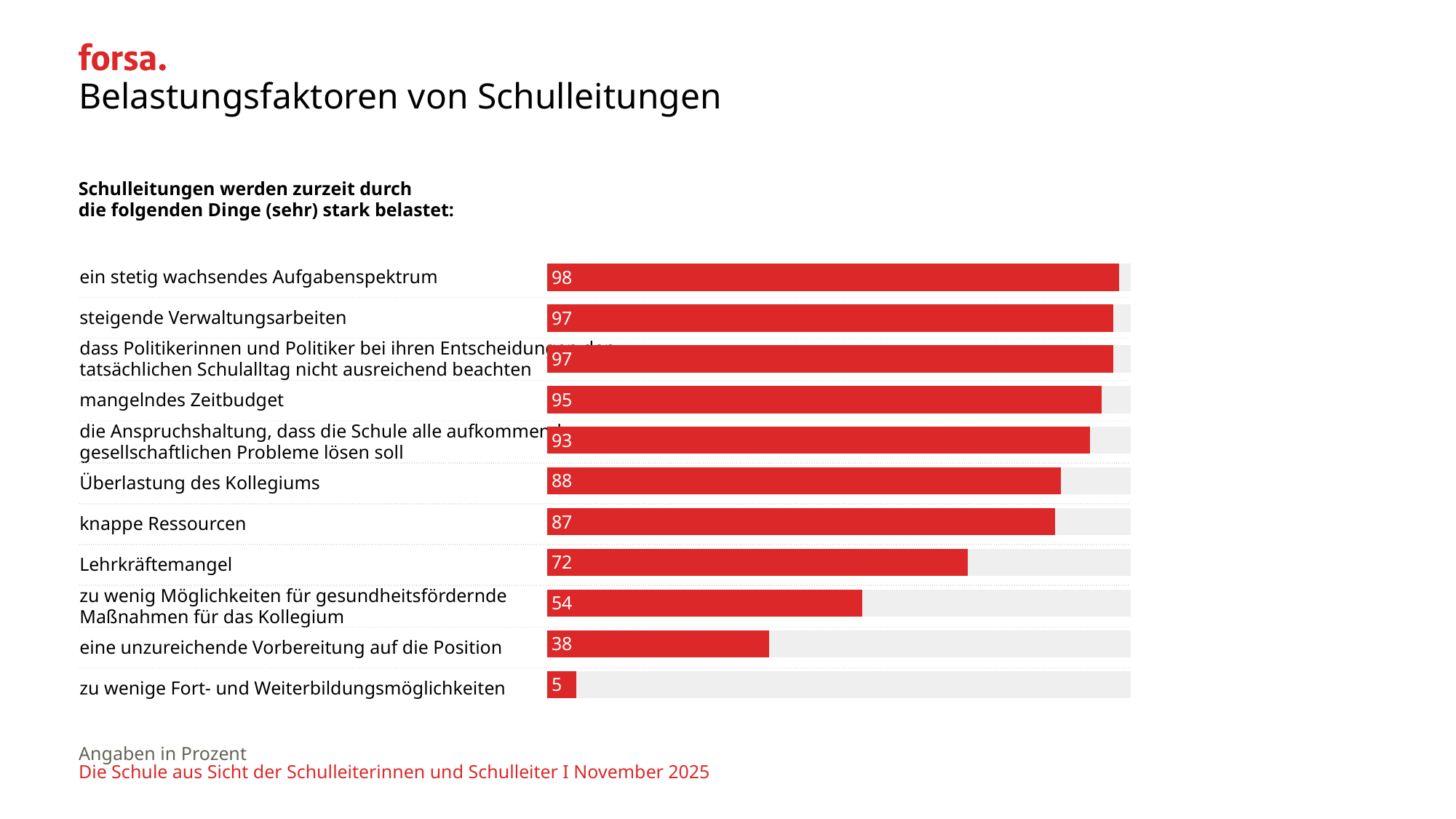
What value is shown for "eine unzureichende Vorbereitung auf die Position"? 38 In what unit are the values given, according to the note below the chart? Prozent Which is larger: the value for "knappe Ressourcen" or the value for "zu wenig Möglichkeiten für gesundheitsfördernde Maßnahmen für das Kollegium"? knappe Ressourcen What is the difference between the values for "Überlastung des Kollegiums" and "Lehrkräftemangel"? 16 Which category has the highest value? ein stetig wachsendes Aufgabenspektrum What kind of chart is shown on the slide? bar chart What value is shown for "mangelndes Zeitbudget"? 95 What is the title of the slide? Belastungsfaktoren von Schulleitungen Which category has the lowest value? zu wenige Fort- und Weiterbildungsmöglichkeiten How many categories are shown in the chart? 11 What is the difference between the values for "ein stetig wachsendes Aufgabenspektrum" and "zu wenige Fort- und Weiterbildungsmöglichkeiten"? 93 What value is shown for "Lehrkräftemangel"? 72